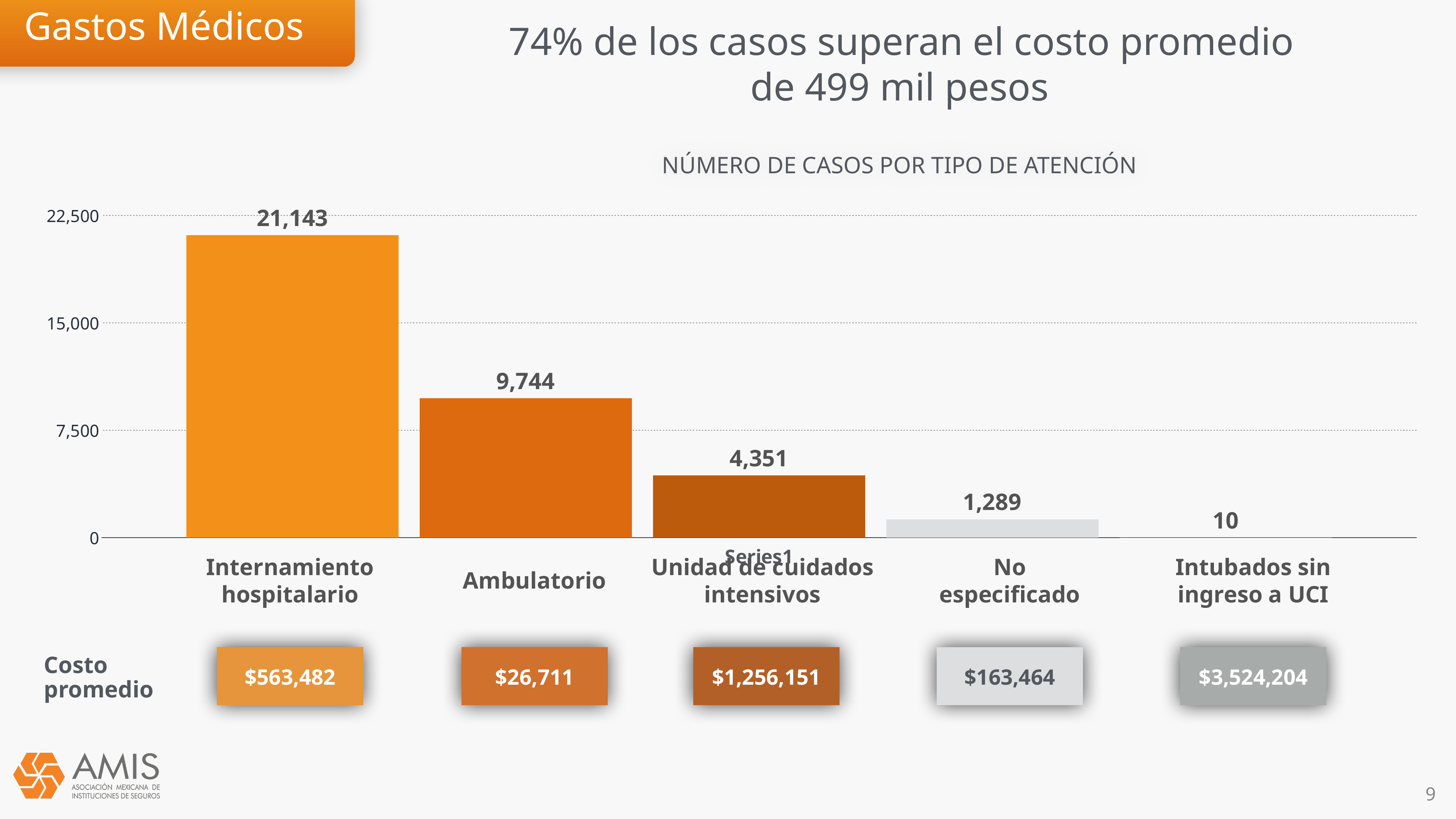
Is the number of cases for Ambulatorio greater or less than 7,500? greater What is the number of cases for Unidad de cuidados intensivos? 4,351 What is the number of cases for Internamiento hospitalario? 21,143 What kind of chart is shown on the slide? Bar chart What is the number of cases for Intubados sin ingreso a UCI? 10 What is the difference in number of cases between Internamiento hospitalario and Ambulatorio? 11,399 What is the title of the chart? NÚMERO DE CASOS POR TIPO DE ATENCIÓN Which type of attention has the highest number of cases? Internamiento hospitalario Which has more cases, Unidad de cuidados intensivos or No especificado? Unidad de cuidados intensivos What is the number of cases for Ambulatorio? 9,744 Which type of attention has the lowest number of cases? Intubados sin ingreso a UCI How many types of attention are shown in the chart? 5